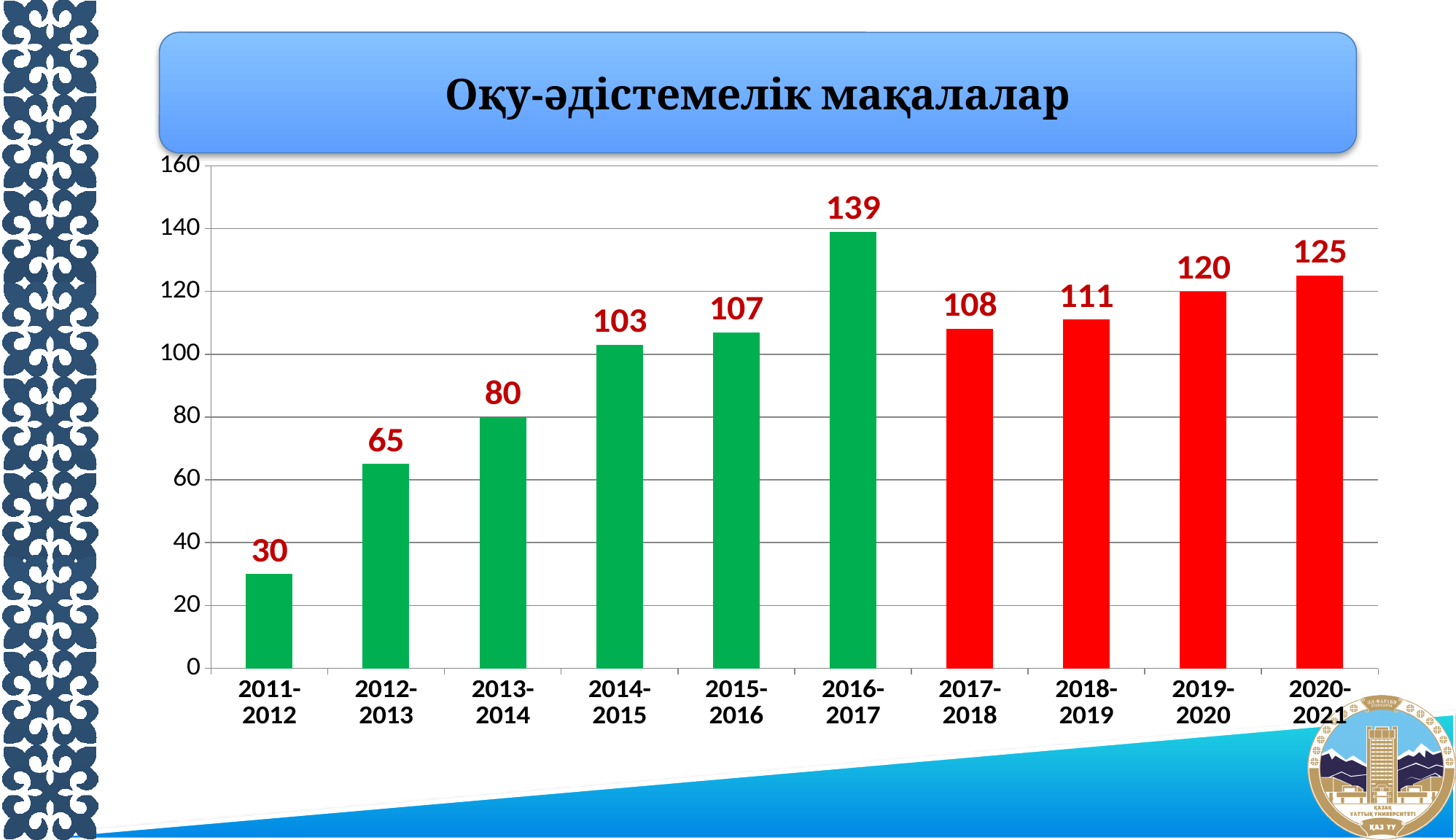
What is the value for 2019-2020? 120 Which year has the lowest value? 2011-2012 What is the difference between the values for 2020-2021 and 2011-2012? 95 How many years are shown on the x axis? 10 What is the value for 2016-2017? 139 What is the difference between the values for 2016-2017 and 2017-2018? 31 What is the value for 2011-2012? 30 What kind of chart is shown on the slide? bar chart Which is larger, the value for 2013-2014 or the value for 2014-2015? 2014-2015 Is the value for 2012-2013 greater or less than 80? less Which year has the highest value? 2016-2017 What is the title of the chart? Оқу-әдістемелік мақалалар